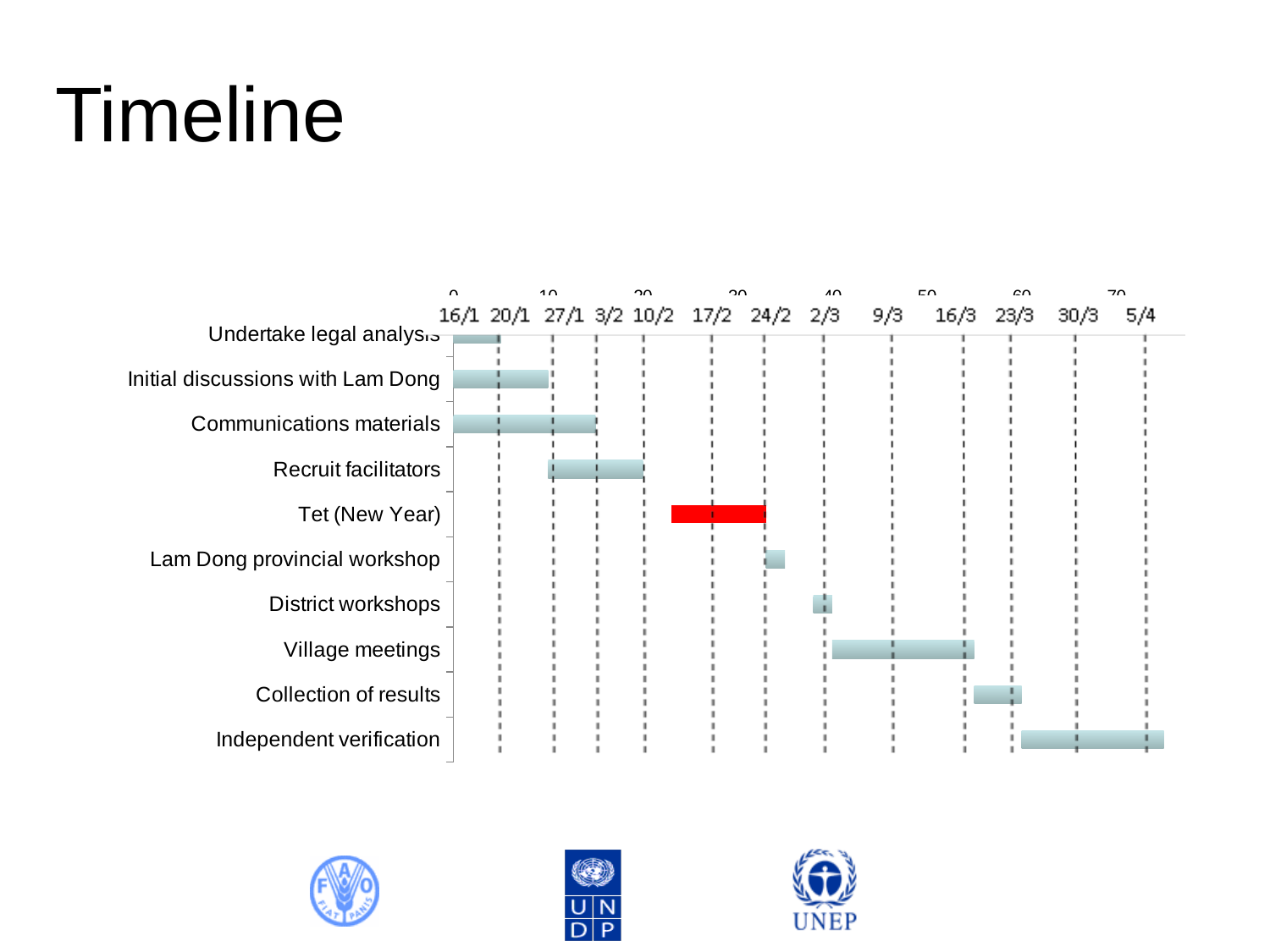
Which task comes immediately after Tet (New Year) on the timeline? Lam Dong provincial workshop What kind of chart is shown on the slide? bar chart Does the Independent verification bar extend beyond the 30/3 tick? yes What is the title of the slide containing the chart? Timeline Does the Village meetings bar start before or after the 9/3 tick? before Does the Recruit facilitators bar start before or after the Tet (New Year) bar? before Which task is scheduled last on the timeline? Independent verification Which task is listed first on the vertical axis? Undertake legal analysis Does the Village meetings bar start before or after the Tet (New Year) bar? after Which task's bar is coloured red? Tet (New Year) How many tasks are listed on the vertical axis of the chart? 10 Do the task bars generally move to the right (later dates) as you go down the list of tasks? yes